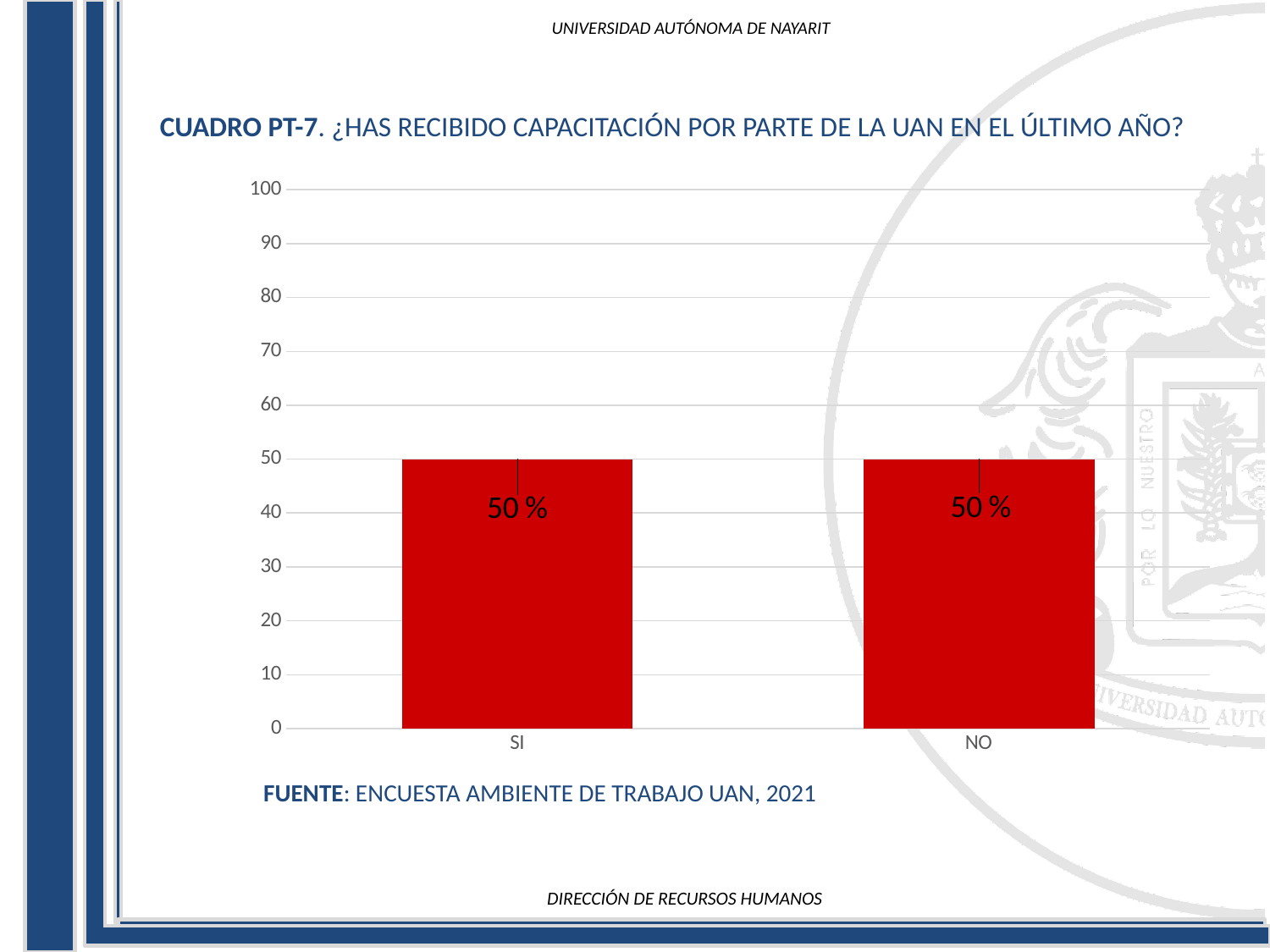
What kind of chart is shown on the slide? bar chart What colour are the bars in the chart? red What is the total of the values for SI and NO? 100 % What is the value for NO? 50 % What is the maximum value shown on the y axis? 100 What is the value for SI? 50 % What is the difference between the values for SI and NO? 0 % Is the value for NO greater or less than 40? greater Is the value for SI greater or less than 60? less How many categories are shown on the x axis? 2